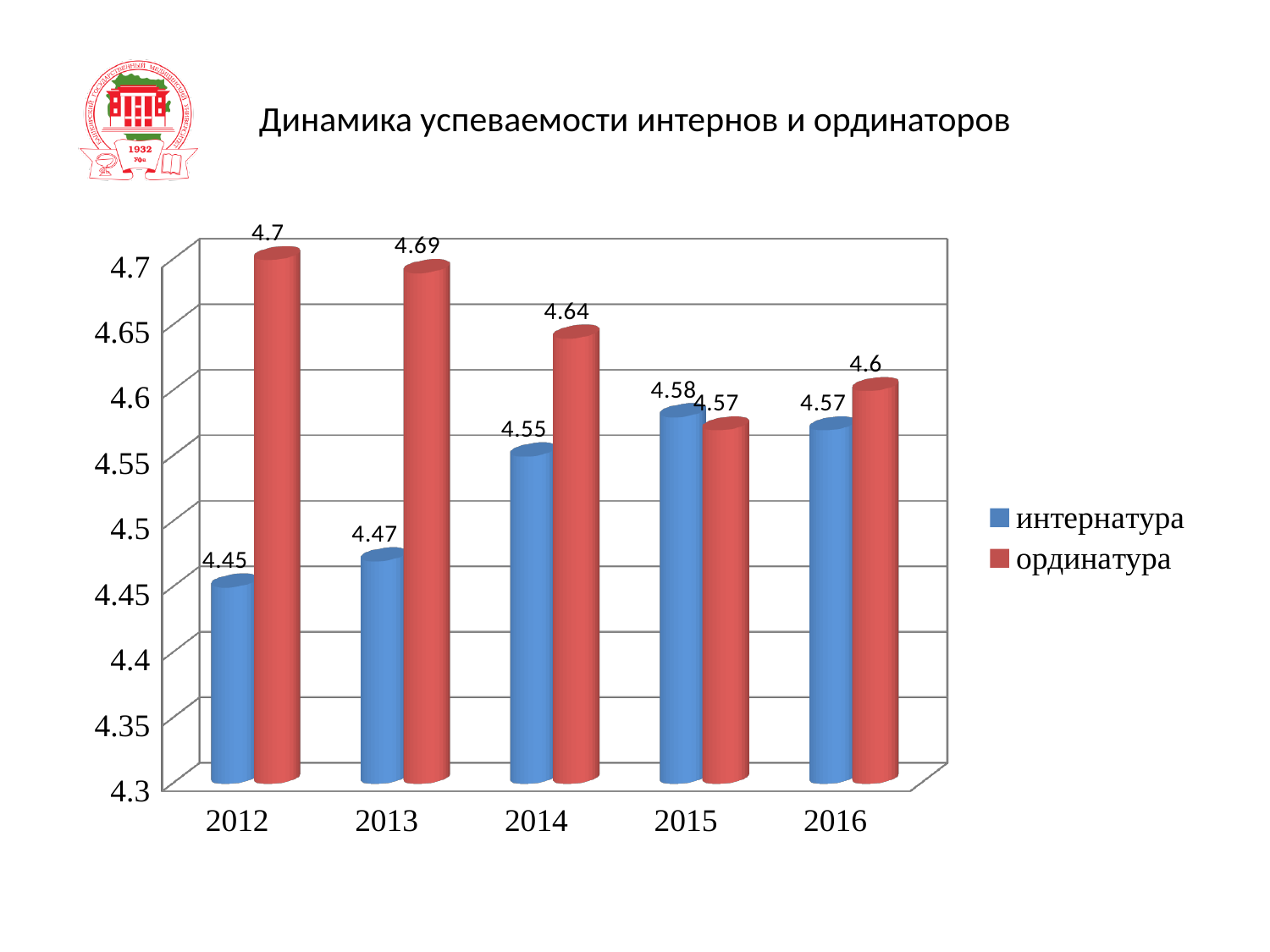
In which year is the ординатура value highest? 2012 Which is larger in 2015: интернатура or ординатура? интернатура Which is larger in 2013: интернатура or ординатура? ординатура What is the value for интернатура in 2012? 4.45 Do the ординатура values rise or fall from 2012 to 2016? fall How many series does the legend list? 2 In which year is the интернатура value lowest? 2012 What is the value for ординатура in 2014? 4.64 What kind of chart is shown on the slide? bar chart What is the difference between ординатура and интернатура in 2012? 0.25 What is the value for интернатура in 2015? 4.58 How many years are shown on the x axis? 5